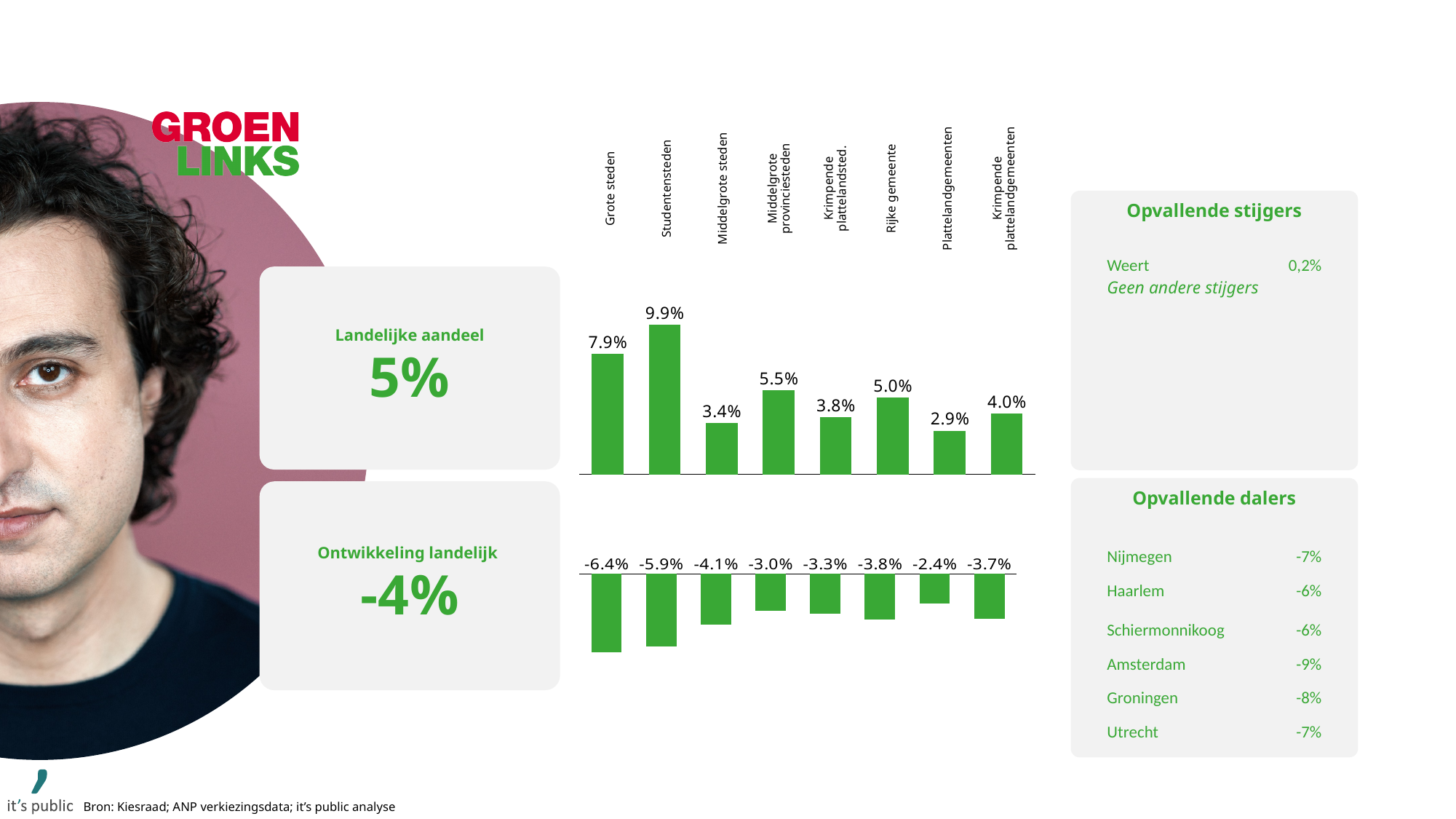
What type of chart is the top chart (Landelijke aandeel)? Bar chart In the top chart (Landelijke aandeel), which category has the highest value? Studentensteden In the bottom chart (Ontwikkeling landelijk), which category has the largest decline? Grote steden In the top chart (Landelijke aandeel), what is the value for Plattelandgemeenten? 2.9% In the bottom chart (Ontwikkeling landelijk), what is the value for Krimpende plattelandgemeenten? -3.7% In the top chart (Landelijke aandeel), which category has the lowest value? Plattelandgemeenten In the top chart (Landelijke aandeel), what is the value for Studentensteden? 9.9% In the top chart (Landelijke aandeel), what is the difference between Grote steden and Middelgrote steden? 4.5% How many categories are shown in the top chart (Landelijke aandeel)? 8 In the bottom chart (Ontwikkeling landelijk), which category has the smallest decline? Plattelandgemeenten In the bottom chart (Ontwikkeling landelijk), what is the value for Grote steden? -6.4% In the top chart (Landelijke aandeel), which is larger: Middelgrote provinciesteden or Rijke gemeente? Middelgrote provinciesteden